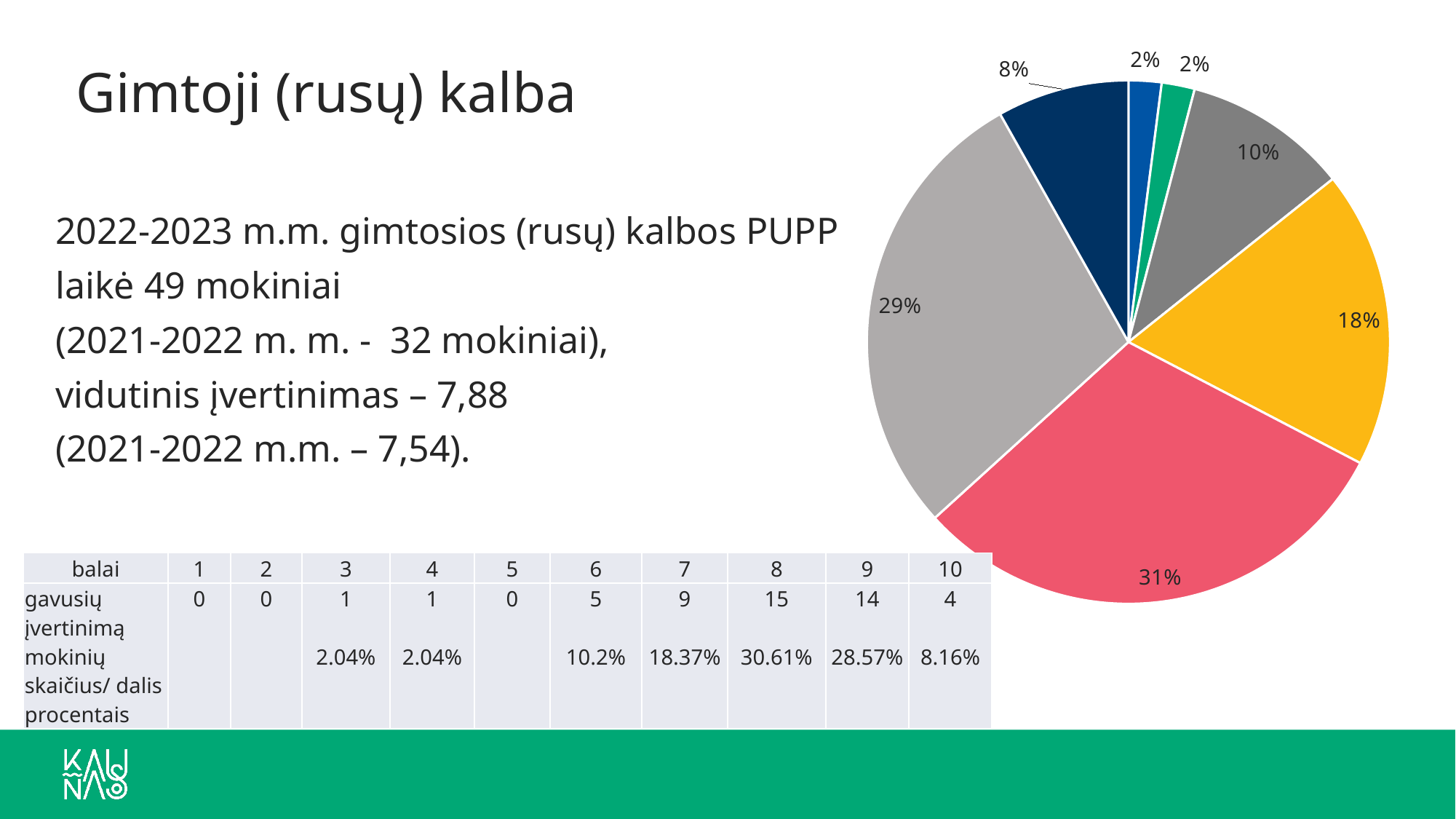
What colour is the largest slice of the pie chart? red Is the share of the red slice greater or less than 30%? greater What is the difference in percentage points between the largest slice (31%) and the second largest slice (29%)? 2 What is the percentage shown on the smallest slices of the pie chart? 2% What percentage is shown on the light grey slice of the pie chart? 29% Which slice is larger: the yellow slice or the dark grey slice? the yellow slice (18%) What kind of chart is shown on the slide? pie chart What is the percentage shown on the largest slice of the pie chart? 31% How many slices of the pie chart are labelled 2%? 2 How many slices does the pie chart have? 7 What percentage is shown on the dark blue slice of the pie chart? 8% What percentage is shown on the yellow slice of the pie chart? 18%